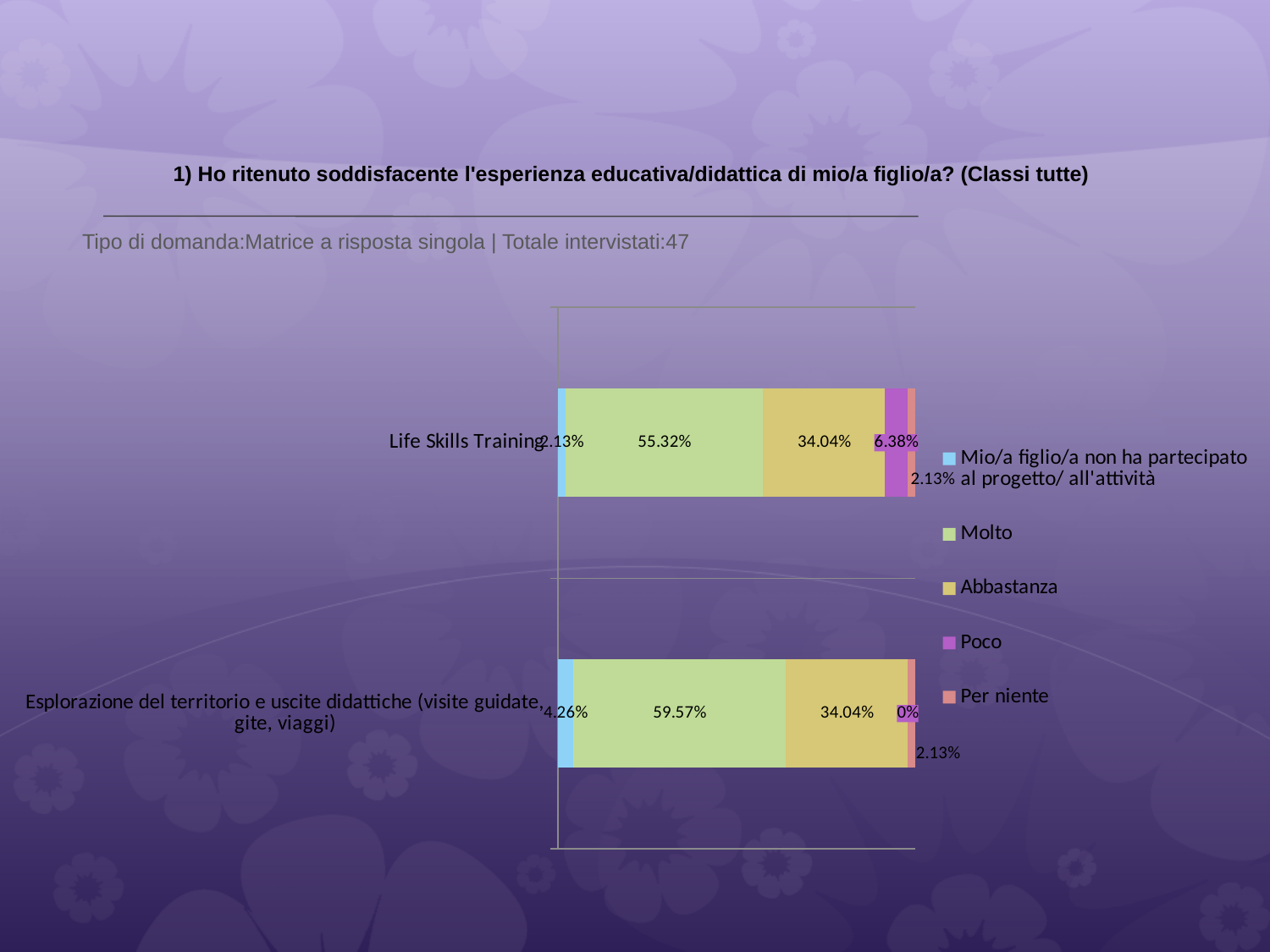
Which category has the larger 'Molto' value, Life Skills Training or Esplorazione del territorio e uscite didattiche? Esplorazione del territorio e uscite didattiche (visite guidate, gite, viaggi) What is the total number of respondents stated on the slide (Totale intervistati)? 47 What is the 'Molto' value for Esplorazione del territorio e uscite didattiche (visite guidate, gite, viaggi)? 59.57% What is the 'Poco' value for Life Skills Training? 6.38% What is the 'Molto' value for Life Skills Training? 55.32% What kind of chart is shown on the slide? Stacked bar chart What is the 'Mio/a figlio/a non ha partecipato al progetto/ all'attività' value for Esplorazione del territorio e uscite didattiche (visite guidate, gite, viaggi)? 4.26% What is the 'Abbastanza' value for Life Skills Training? 34.04% How many categories (bars) are plotted in the chart? 2 What is the 'Poco' value for Esplorazione del territorio e uscite didattiche (visite guidate, gite, viaggi)? 0% How many series does the legend list? 5 What is the difference between the 'Molto' values for Esplorazione del territorio e uscite didattiche and Life Skills Training? 4.25%